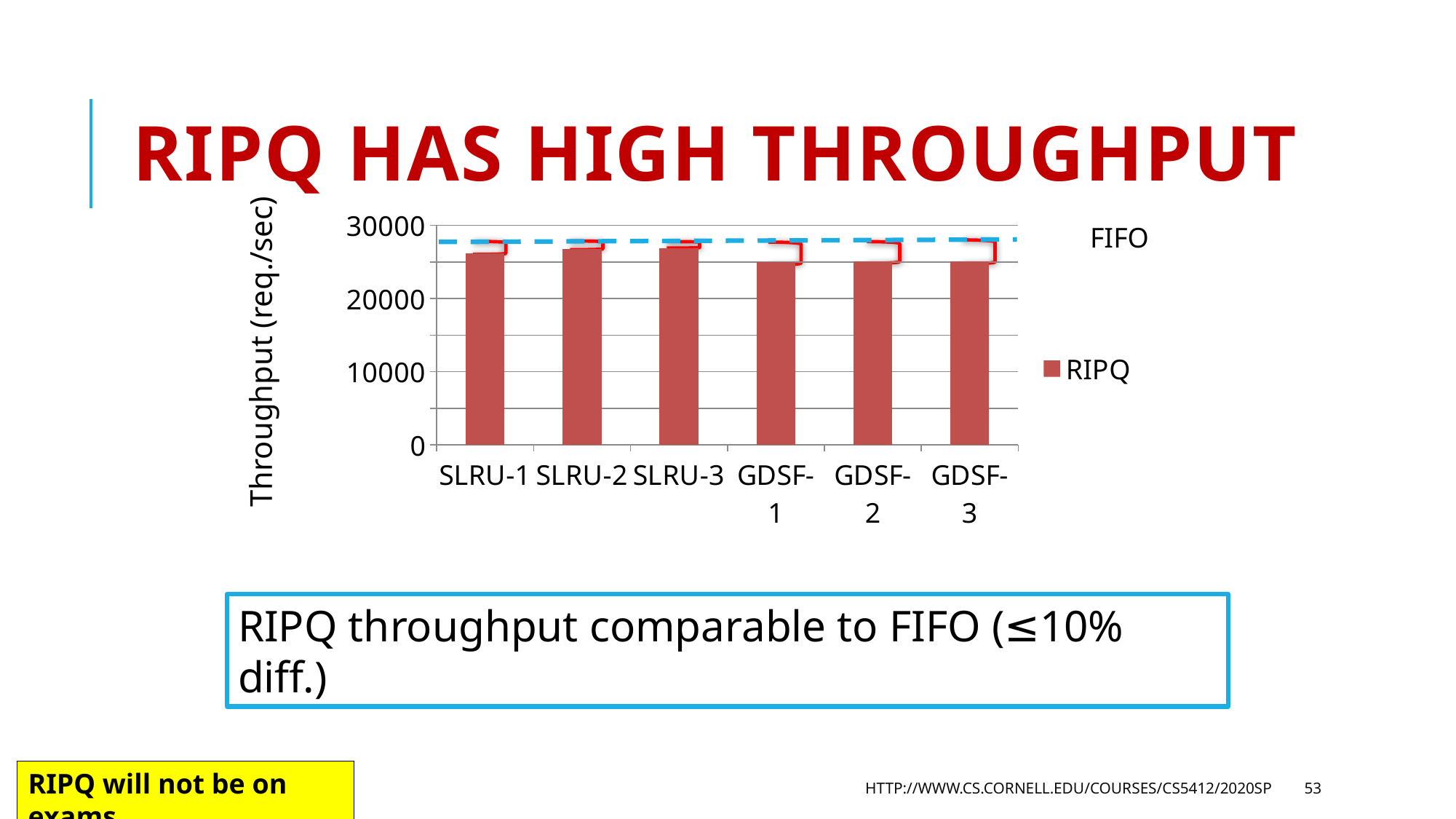
Do the RIPQ bars rise sharply, fall sharply, or stay roughly level across the x axis? roughly level Is the RIPQ value for GDSF-1 greater or less than 20000? greater Is the RIPQ value for SLRU-1 greater or less than 20000? greater Is the RIPQ value for SLRU-2 greater or less than 30000? less What kind of chart is shown on the slide? bar chart How many series does the chart's legend list? 1 What is the label on the chart's y axis? Throughput (req./sec) What does the dashed blue horizontal line on the chart represent? FIFO How many categories are shown on the x axis of the chart? 6